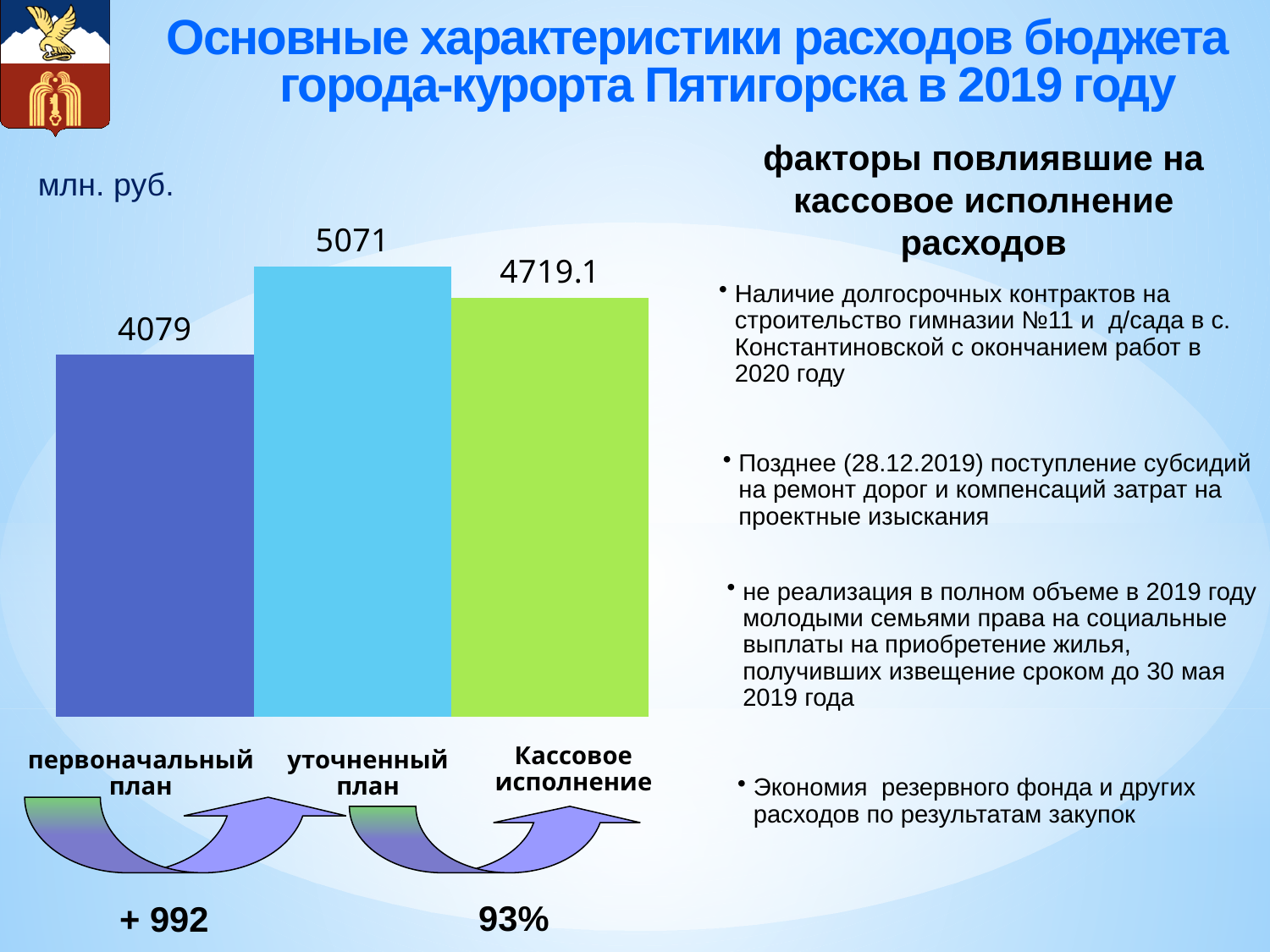
Which category has the lowest value? первоначальный план What is the difference between Кассовое исполнение and первоначальный план? 640.1 Which category has the highest value? уточненный план In what units are the chart values given? млн. руб. Which is larger, Кассовое исполнение or первоначальный план? Кассовое исполнение What is the value for первоначальный план? 4079 What is the difference between уточненный план and Кассовое исполнение? 351.9 What is the value for уточненный план? 5071 What kind of chart is shown on the slide? bar chart How many bars are shown in the chart? 3 What is the value for Кассовое исполнение? 4719.1 What is the difference between уточненный план and первоначальный план? 992